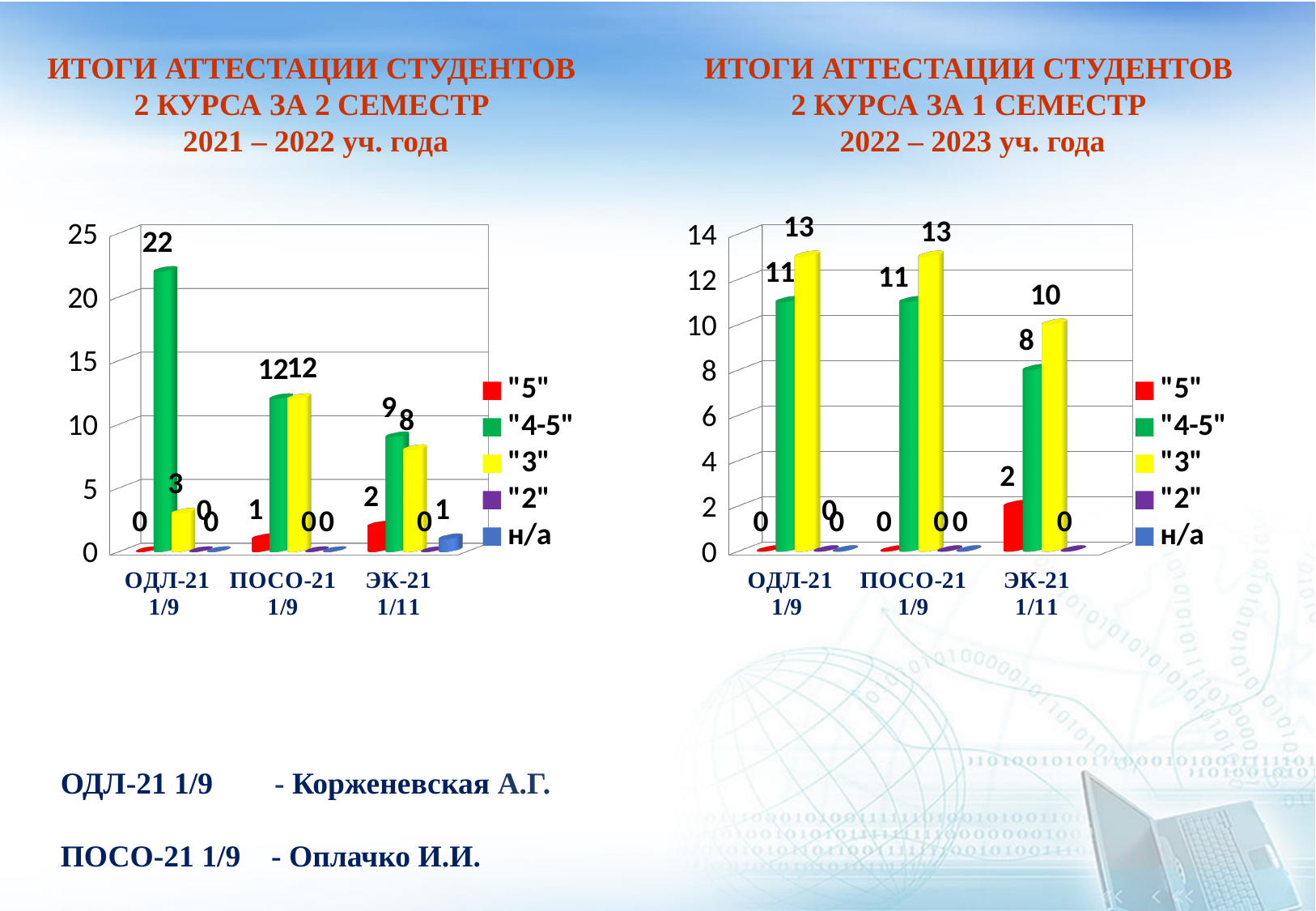
In the left chart (2 семестр 2021 – 2022), what is the difference between the "4-5" values for ОДЛ-21 1/9 and ЭК-21 1/11? 13 In the right chart (1 семестр 2022 – 2023), what is the value of "5" for ЭК-21 1/11? 2 In the left chart (2 семестр 2021 – 2022), which group has the highest "4-5" value? ОДЛ-21 1/9 How many series does the legend of the left chart (2 семестр 2021 – 2022) list? 5 In the right chart (1 семестр 2022 – 2023), which is larger for ЭК-21 1/11: "4-5" or "3"? "3" What type of chart is the right chart (1 семестр 2022 – 2023)? Bar chart In the left chart (2 семестр 2021 – 2022), what is the value of "4-5" for ОДЛ-21 1/9? 22 In the right chart (1 семестр 2022 – 2023), which group has the lowest "3" value? ЭК-21 1/11 How many groups are shown on the x axis of the right chart (1 семестр 2022 – 2023)? 3 In the left chart (2 семестр 2021 – 2022), what is the value of "3" for ЭК-21 1/11? 8 In the right chart (1 семестр 2022 – 2023), what is the value of "3" for ПОСО-21 1/9? 13 In the left chart (2 семестр 2021 – 2022), is the "4-5" value for ОДЛ-21 1/9 greater or less than 20? greater